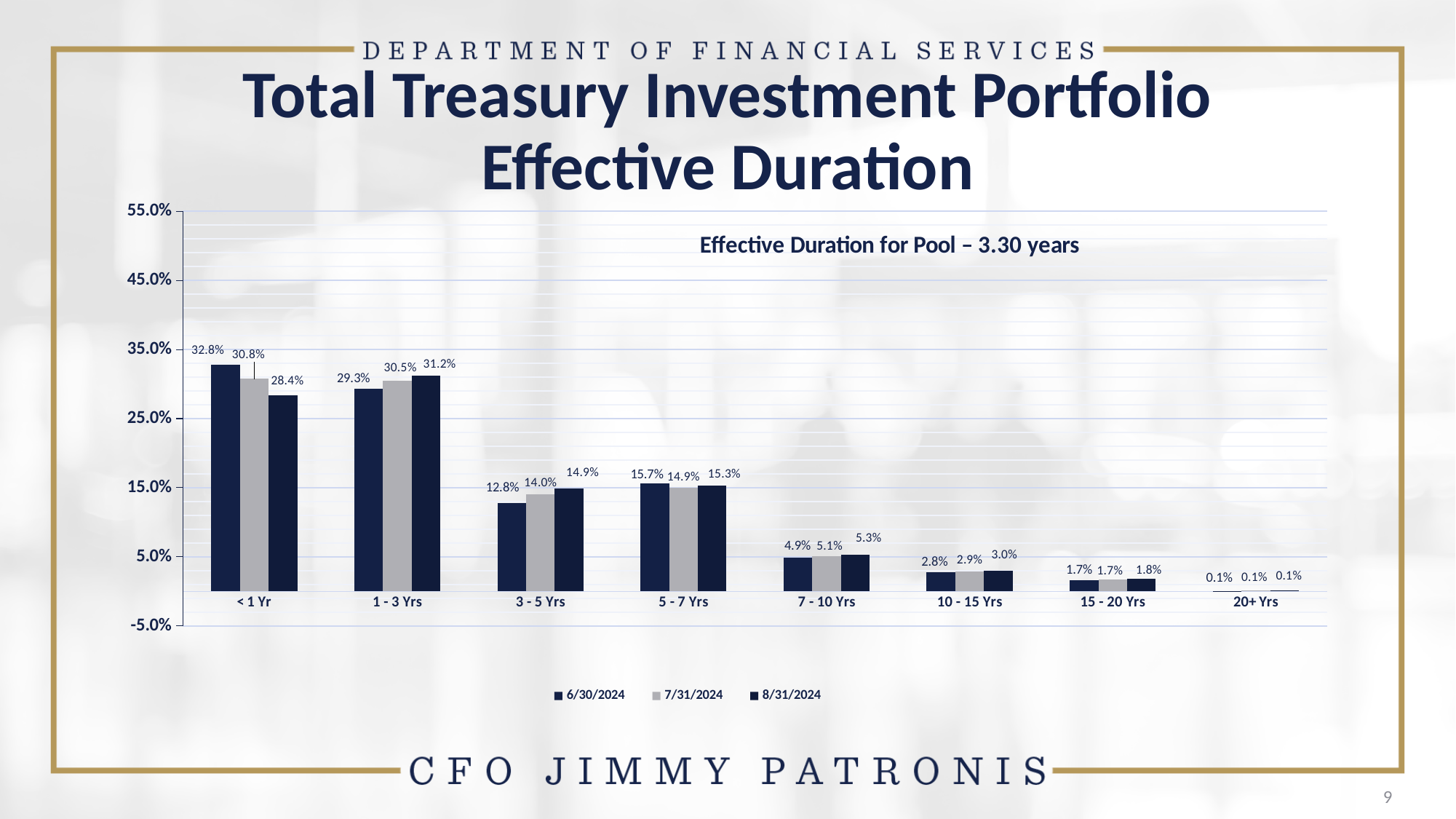
What is the difference between the 6/30/2024 and 8/31/2024 values in the < 1 Yr category? 4.4% What is the value for the 7/31/2024 series in the 3 - 5 Yrs category? 14.0% What is the effective duration for the pool stated on the chart? 3.30 years Which category has the lowest value for the 6/30/2024 series? 20+ Yrs What is the value for the 6/30/2024 series in the 5 - 7 Yrs category? 15.7% What is the value for the 8/31/2024 series in the < 1 Yr category? 28.4% Is the 7/31/2024 value for the 7 - 10 Yrs category greater or less than 15.0%? less How many series does the legend list? 3 Which is larger in the 1 - 3 Yrs category: the 6/30/2024 value or the 8/31/2024 value? 8/31/2024 Which category has the highest value for the 8/31/2024 series? 1 - 3 Yrs How many categories are shown on the x axis? 8 What kind of chart is shown on the slide? bar chart